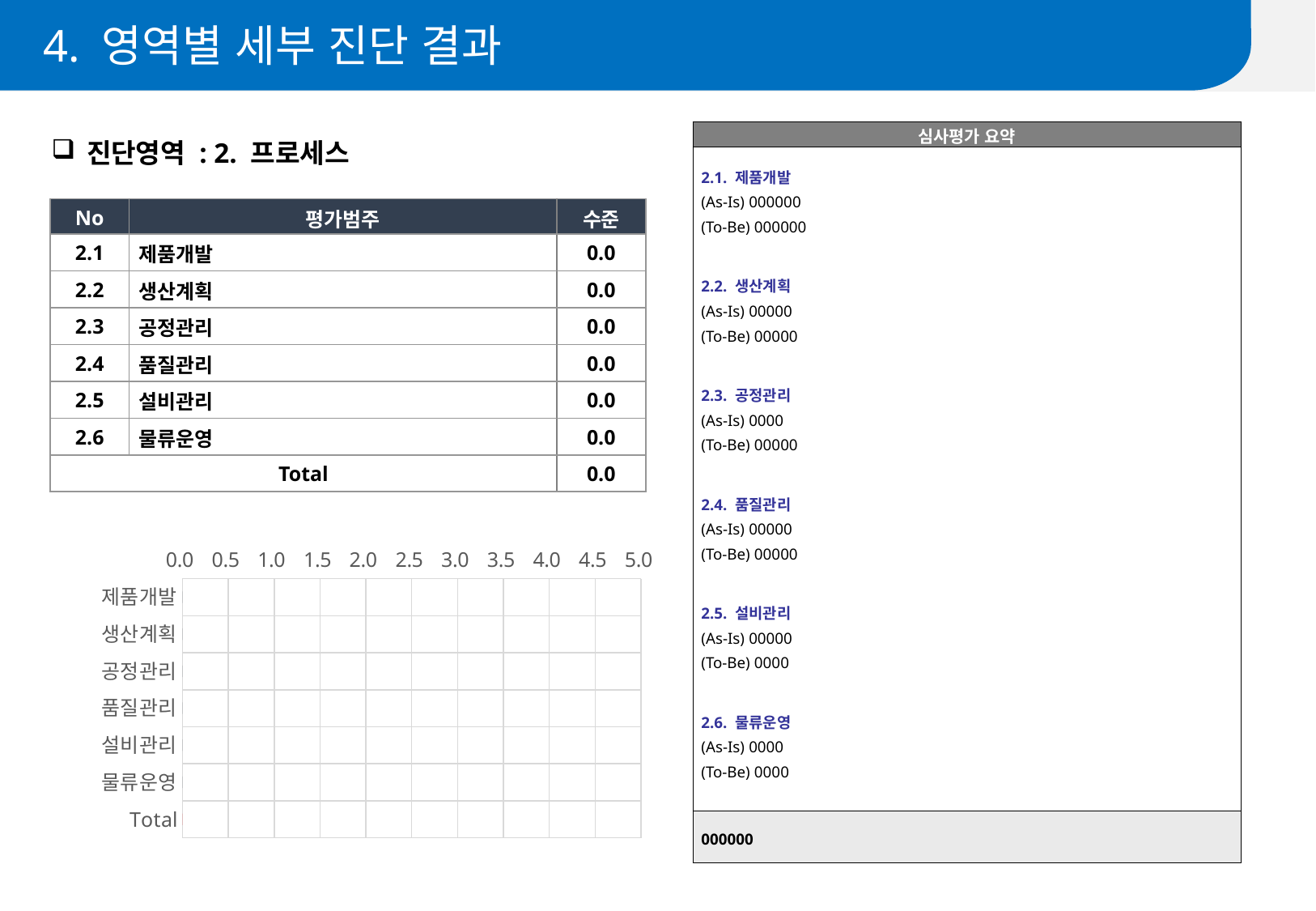
Is the value for 생산계획 greater or less than 2.5? less What is the difference between the values for 공정관리 and 설비관리 on the chart? 0.0 How many categories are listed on the chart's vertical axis? 7 What is the value for 제품개발 on the chart? 0.0 What is the highest value shown on the chart's horizontal axis? 5.0 Is the value for 품질관리 greater or less than 1.0? less What is the value for 물류운영 on the chart? 0.0 Is the value for Total greater or less than 4.0? less What is the value for Total on the chart? 0.0 What kind of chart is shown on the slide? bar chart What is the lowest value shown on the chart's horizontal axis? 0.0